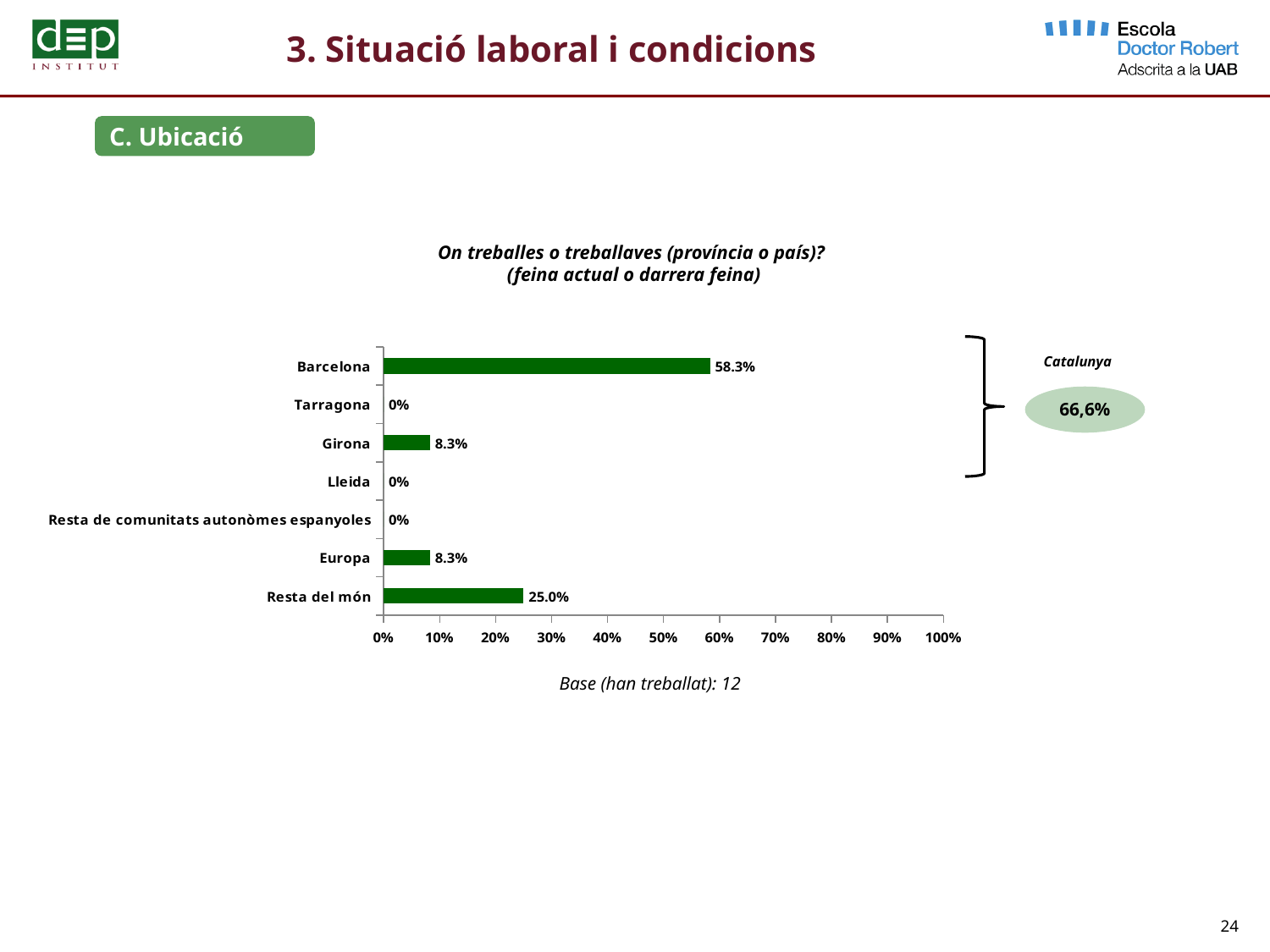
What is the difference between the values for Barcelona and Resta del món? 33.3% How many categories have a value of 0%? 3 What kind of chart is shown on the slide? Bar chart Which category has the highest value? Barcelona What percentage is shown in the oval labelled Catalunya next to the chart? 66,6% What is the value for Barcelona? 58.3% How many categories are shown in the chart? 7 What is the value for Resta del món? 25.0% Is the value for Barcelona greater or less than 50%? greater What is the value for Girona? 8.3% What is the value for Tarragona? 0% Which is larger, the value for Europa or the value for Resta del món? Resta del món